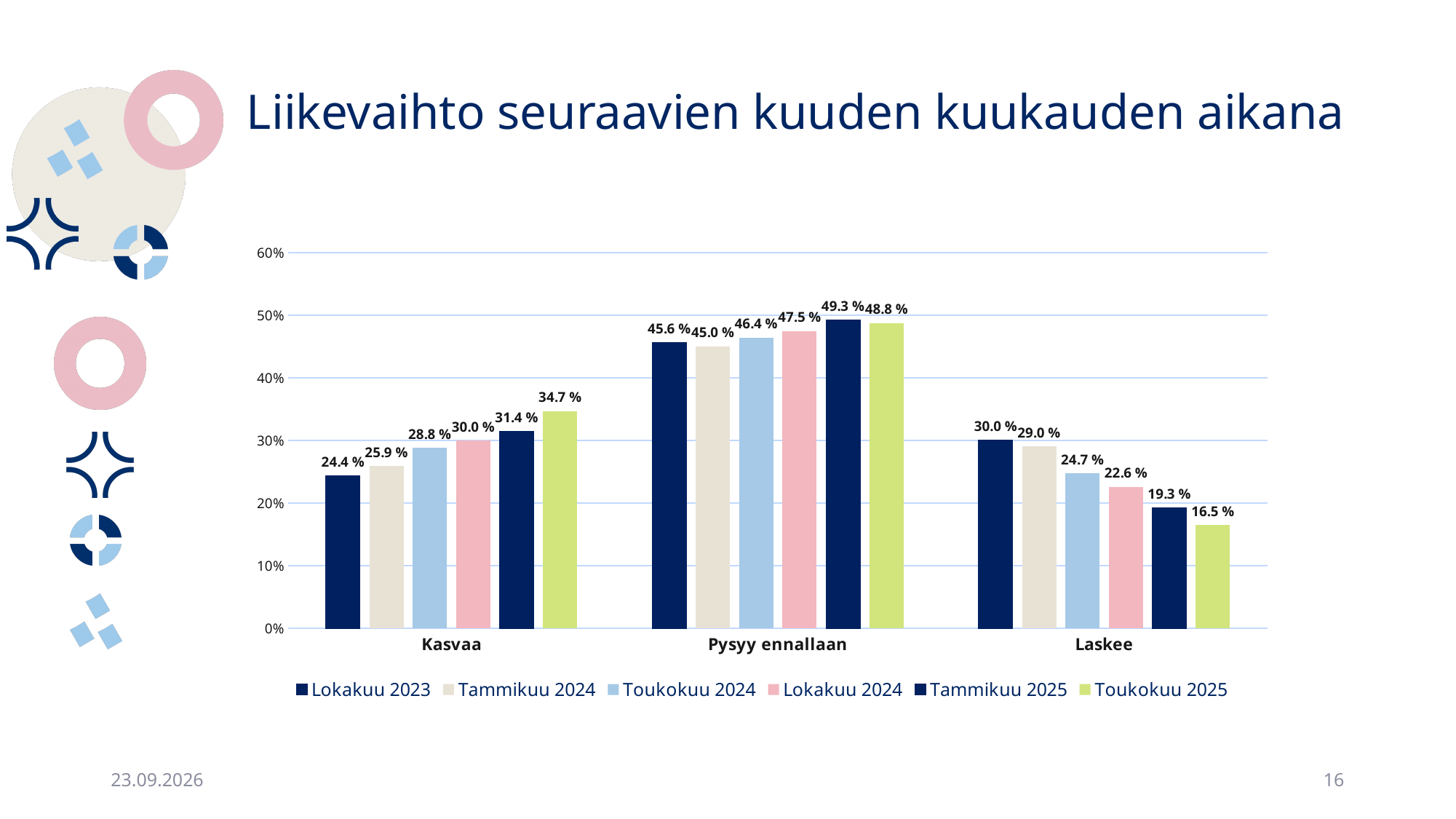
Which series has the highest value in the Pysyy ennallaan category? Tammikuu 2025 What is the difference between the Toukokuu 2025 and Lokakuu 2023 values in the Kasvaa category? 10.3 percentage points What is the value for Toukokuu 2025 in the Kasvaa category? 34.7 % What is the value for Lokakuu 2024 in the Laskee category? 22.6 % In the Laskee category, do the values rise or fall from Lokakuu 2023 to Toukokuu 2025? fall How many categories are shown on the x axis? 3 What is the value for Toukokuu 2024 in the Pysyy ennallaan category? 46.4 % Is the value for Lokakuu 2024 in the Pysyy ennallaan category greater or less than 40%? greater Which is larger for Tammikuu 2024: the Kasvaa value or the Laskee value? Laskee Which series has the lowest value in the Laskee category? Toukokuu 2025 What kind of chart is shown on the slide? bar chart How many series does the legend list? 6